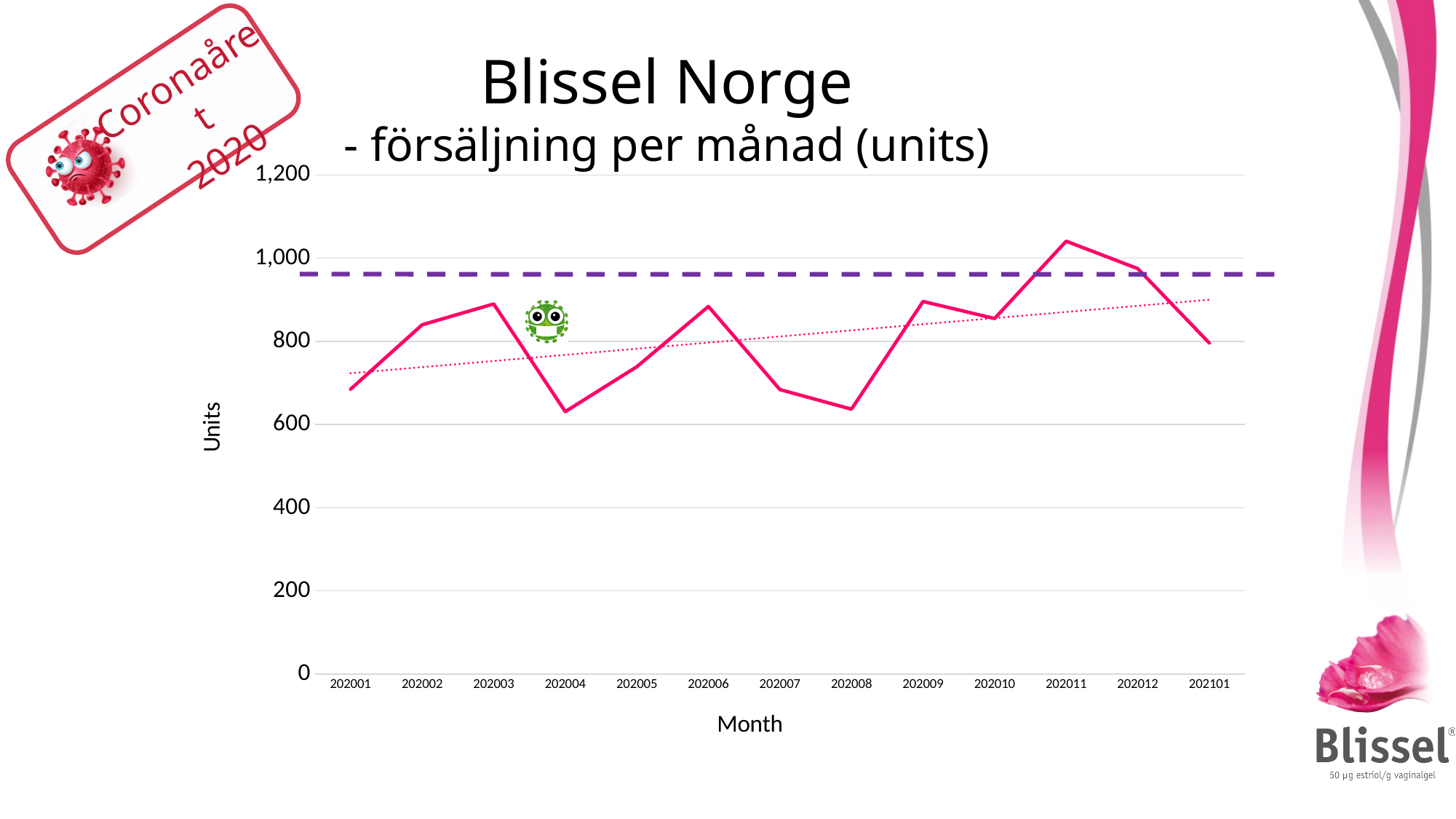
Which is larger, the value for 202002 or the value for 202007? 202002 What is the title of the x axis? Month Is the value for 202004 greater or less than 800? less Is the value for 202008 greater or less than 800? less Is the value for 202002 greater or less than 800? greater Which month has the highest value? 202011 Do the values rise or fall from 202008 to 202011? rise Which is larger, the value for 202011 or the value for 202004? 202011 How many months are plotted along the x axis? 13 What kind of chart is shown on the slide? line chart